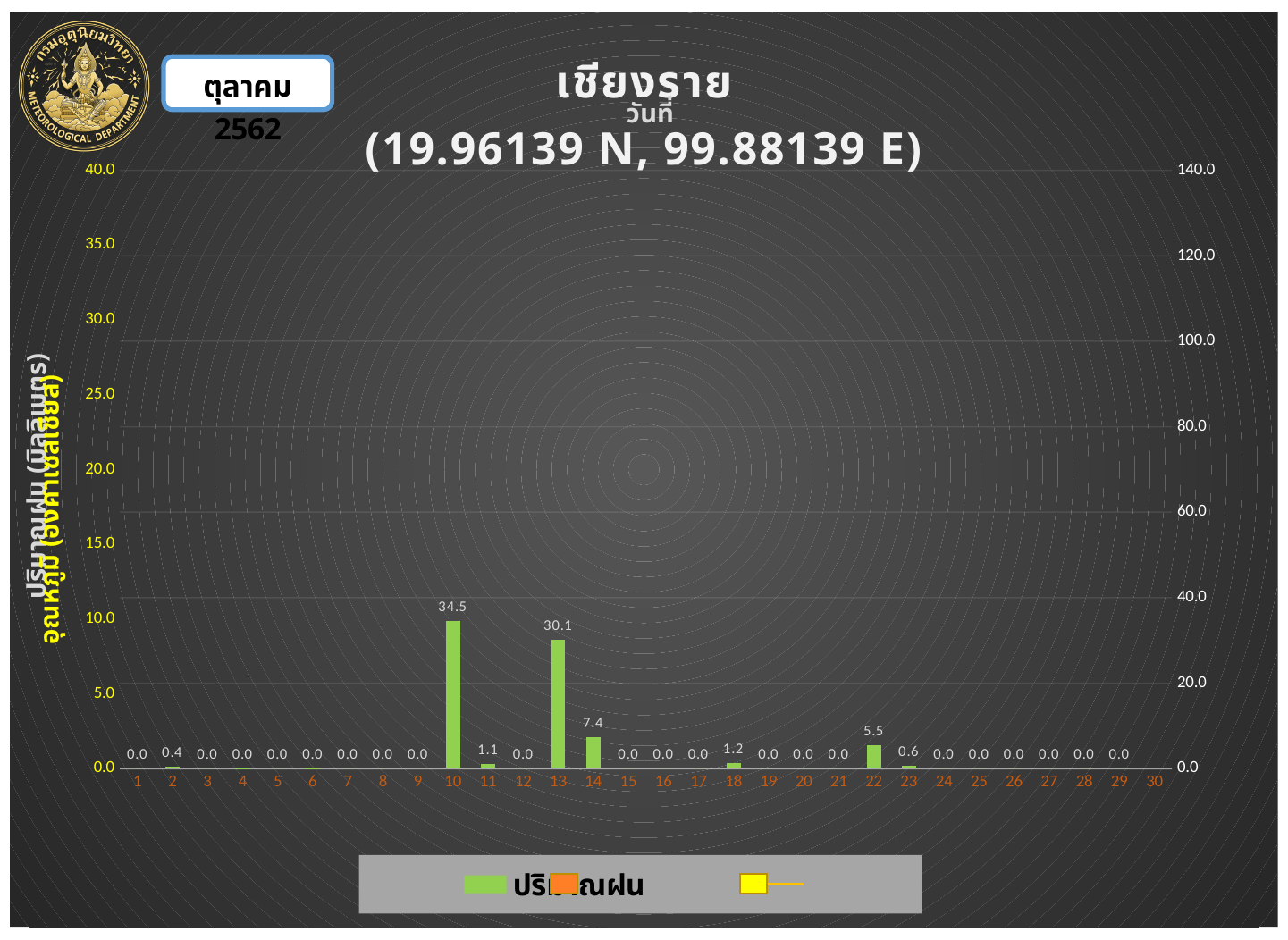
What is the rainfall value shown for day 13? 30.1 What kind of chart is shown on the slide? bar chart Which day has the highest rainfall value? 10 How many days are shown on the x axis? 30 Which day has the larger rainfall value, day 14 or day 22? 14 What coordinates are given in the chart title? 19.96139 N, 99.88139 E What is the difference between the rainfall values for day 10 and day 13? 4.4 What is the rainfall value shown for day 18? 1.2 What is the rainfall value shown for day 14? 7.4 What is the rainfall value shown for day 22? 5.5 Is the rainfall value for day 10 greater or less than 20.0 on the right-hand axis? greater What is the rainfall value shown for day 10? 34.5